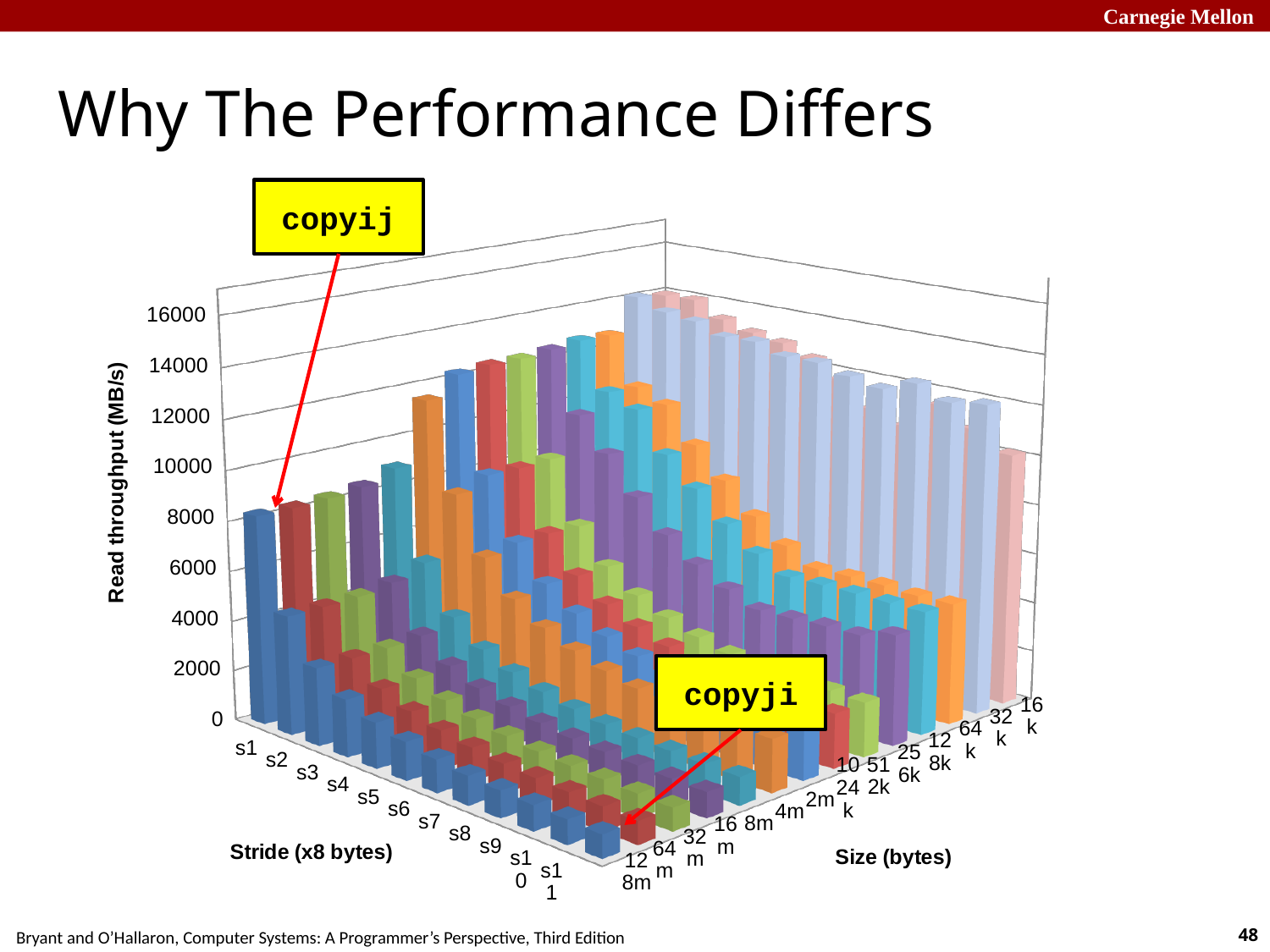
What two function names are shown in the yellow callout boxes on the chart? copyij and copyji Is the read throughput for stride s11 at size 128m greater or less than 4000? less Which stride has the higher read throughput at size 128m, s1 or s11? s1 What is the title of the vertical axis? Read throughput (MB/s) How many stride categories (s1 through s11) are shown along the Stride axis? 11 How many size categories are shown along the Size (bytes) axis? 14 For the 128m size, does read throughput rise or fall as stride increases from s1 to s11? fall Is the read throughput for stride s1 at size 128m greater or less than 12000? less What kind of chart is shown on the slide? 3D bar chart Is the read throughput for stride s1 at size 128m greater or less than 4000? greater